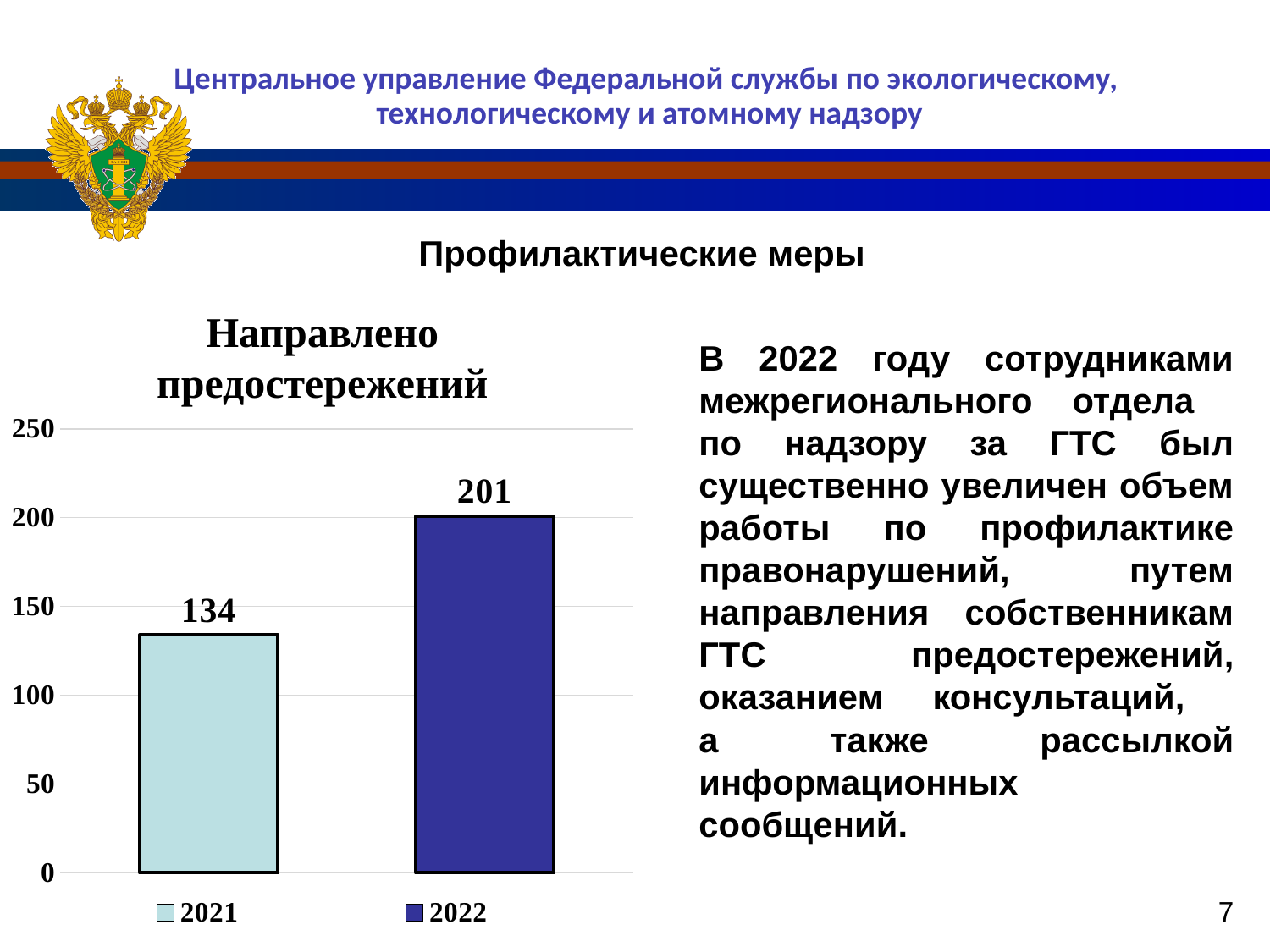
Is the value for 2022 larger than the value for 2021? Yes What is the value for 2022 in the chart? 201 Which year has the higher value in the chart? 2022 How many bars are plotted in the chart? 2 What is the title of the chart? Направлено предостережений What is the difference between the 2022 and 2021 values? 67 Is the value for 2021 greater or less than 150? less Which year has the lower value in the chart? 2021 What kind of chart is shown on the slide? Bar chart How many series does the legend list? 2 Is the value for 2022 greater or less than 200? greater What is the value for 2021 in the chart? 134